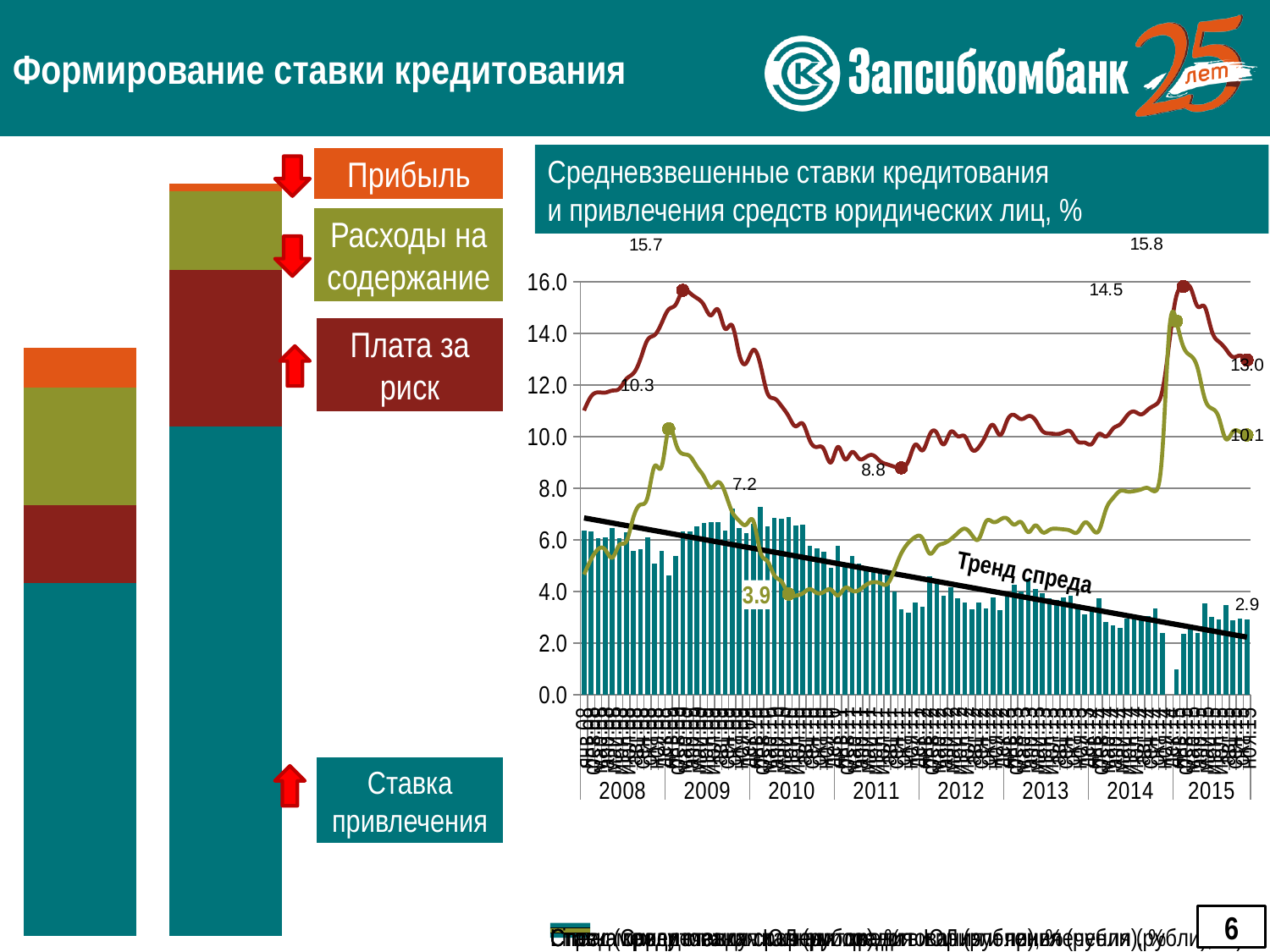
How many years are labelled along the x axis of the chart? 8 What is the title of the chart on the right side of the slide? Средневзвешенные ставки кредитования и привлечения средств юридических лиц, % What is the last labelled value of the dark red line at the right end of the chart (2015)? 13.0 At the right end of the chart, how much higher is the dark red line's labelled value (13.0) than the olive green line's labelled value (10.1)? 2.9 What is the highest labelled value on the dark red line in the chart? 15.8 What is the lowest labelled value on the dark red line in the chart? 8.8 What is the highest labelled value on the olive green line in the chart? 14.5 Do the bars in the chart generally rise or fall from 2008 to 2015? Fall What value is labelled on the last bar at the right end of the chart (2015)? 2.9 What is the last labelled value of the olive green line at the right end of the chart (2015)? 10.1 What is the difference between the two labelled peaks of the dark red line, 15.8 and 15.7? 0.1 What kind of chart is shown on the right side of the slide? A combined bar and line chart